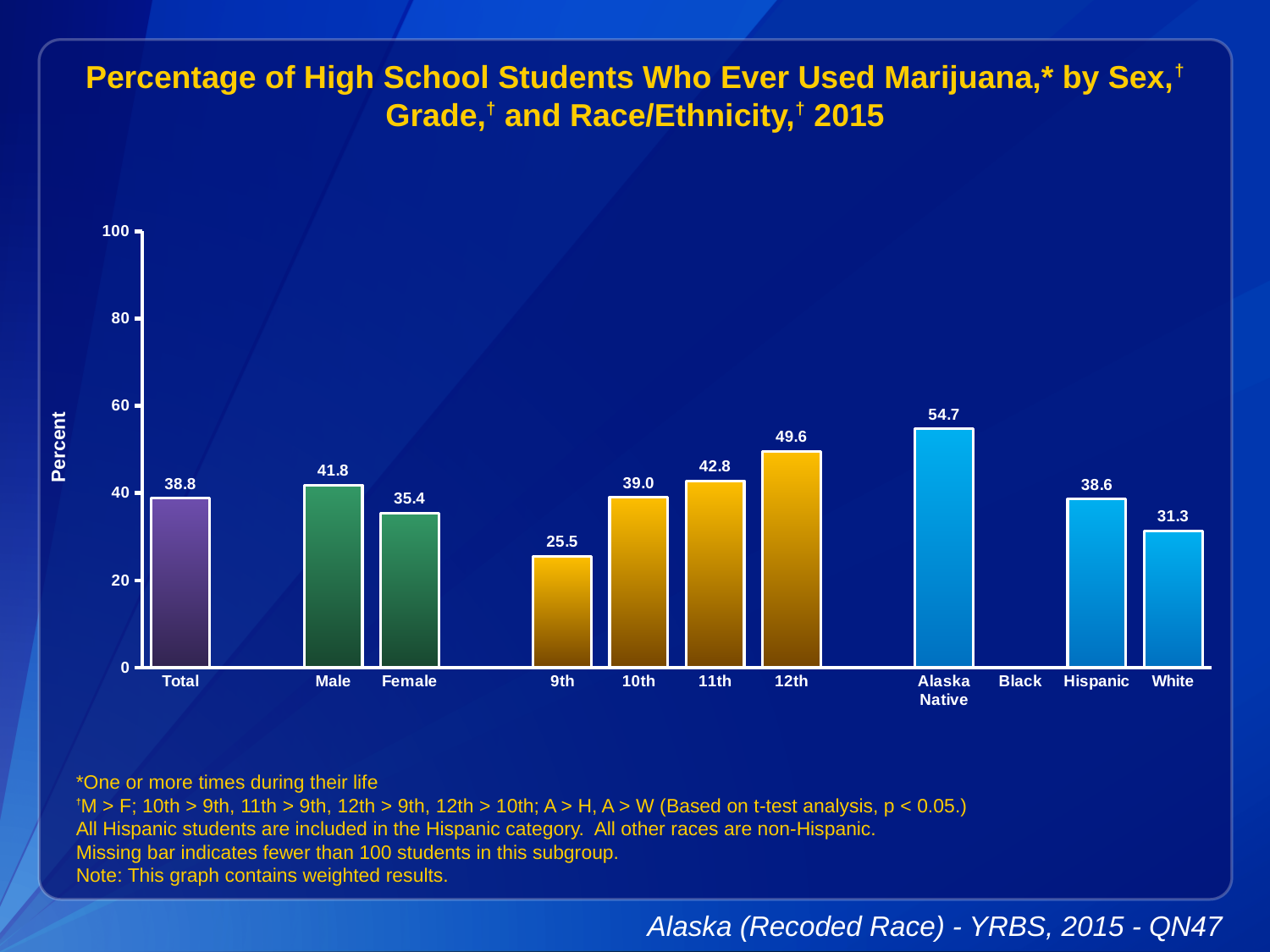
What is the value for Female? 35.4 What is the difference between the Male and Female values? 6.4 Do the values rise or fall from 9th grade to 12th grade? rise What kind of chart is shown on the slide? bar chart What is the value for 12th grade? 49.6 Which category has the lowest value? 9th Is the value for 11th grade greater or less than 40? greater Which category has the highest value? Alaska Native Which is larger, the value for Hispanic or the value for White? Hispanic Which race/ethnicity category has no bar shown? Black What is the value for Alaska Native? 54.7 What is the value for Total? 38.8